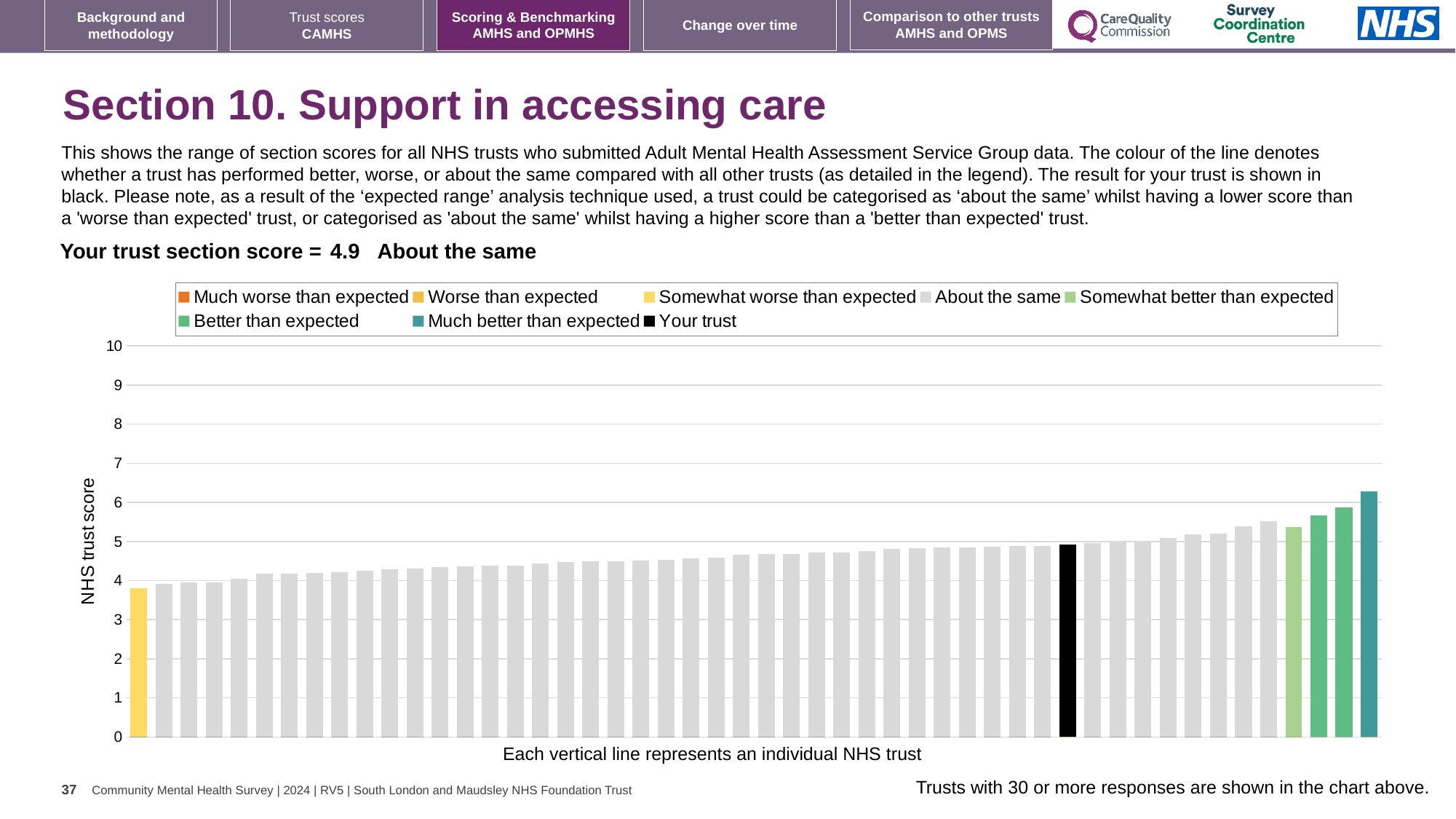
Is the value of the shortest bar greater or less than 4? less Do the bar values rise or fall from left to right along the x axis? rise Which legend category does the shortest bar belong to? Somewhat worse than expected Which legend category does the tallest bar belong to? Much better than expected How many bars are coloured as 'Better than expected'? 2 Is the value for your trust greater or less than 4? greater How many entries does the chart legend list? 8 Is the value for your trust greater or less than 5? less What is the label on the y axis of the chart? NHS trust score What kind of chart is shown on the slide? bar chart What is the section score for your trust? 4.9